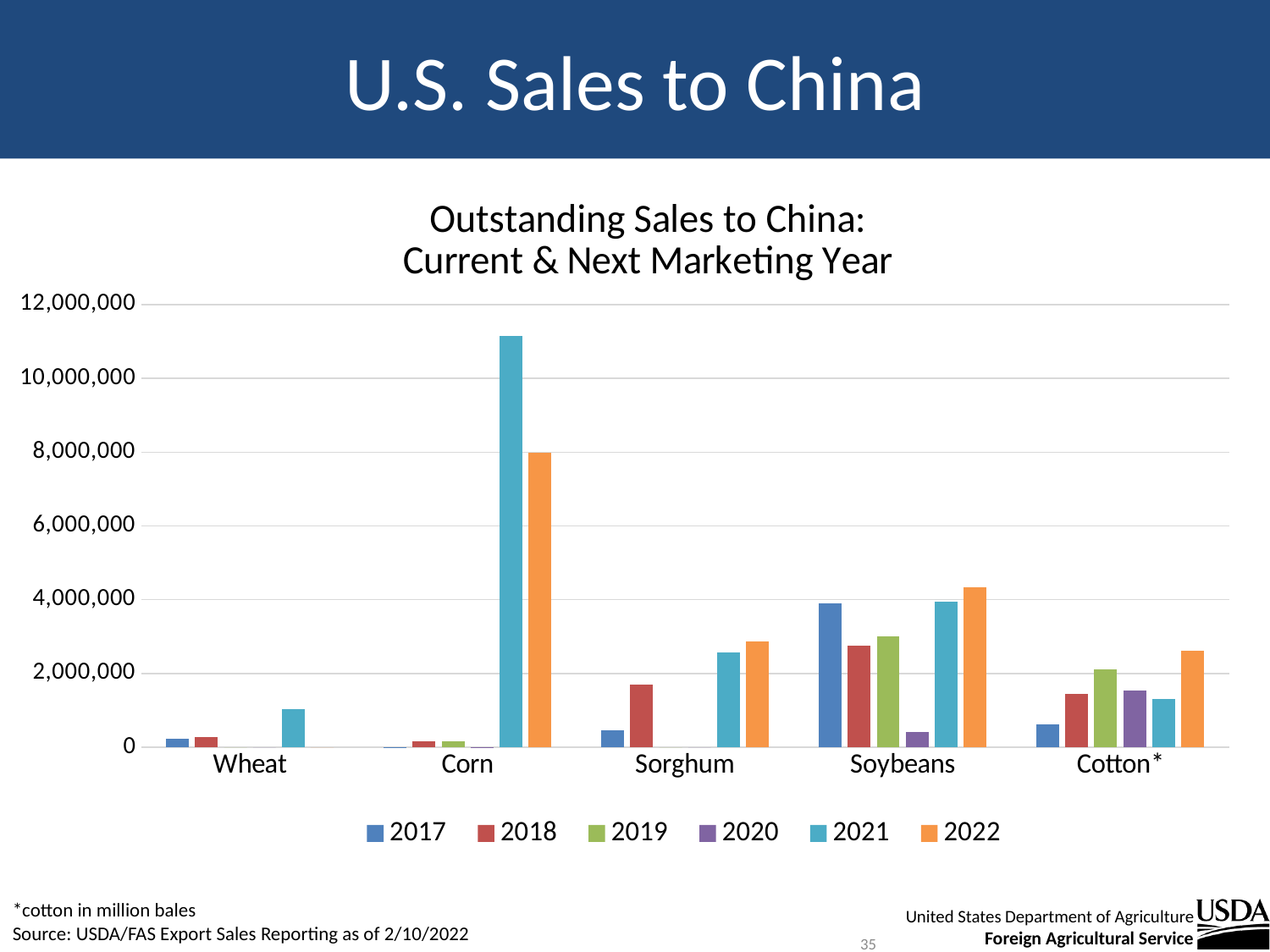
For Sorghum, which is larger: the 2018 value or the 2021 value? 2021 Which year has the highest outstanding sales for Cotton*? 2022 How many series does the legend list? 6 What is the title of the chart? Outstanding Sales to China: Current & Next Marketing Year What kind of chart is shown on the slide? Bar chart Is the value for Corn in 2021 greater or less than 10,000,000? greater Which year has the lowest outstanding sales for Soybeans? 2020 Is the value for Corn in 2022 greater or less than 6,000,000? greater Which year has the highest outstanding sales for Corn? 2021 Is the value for Soybeans in 2022 greater or less than 4,000,000? greater How many commodity categories are shown on the x axis? 5